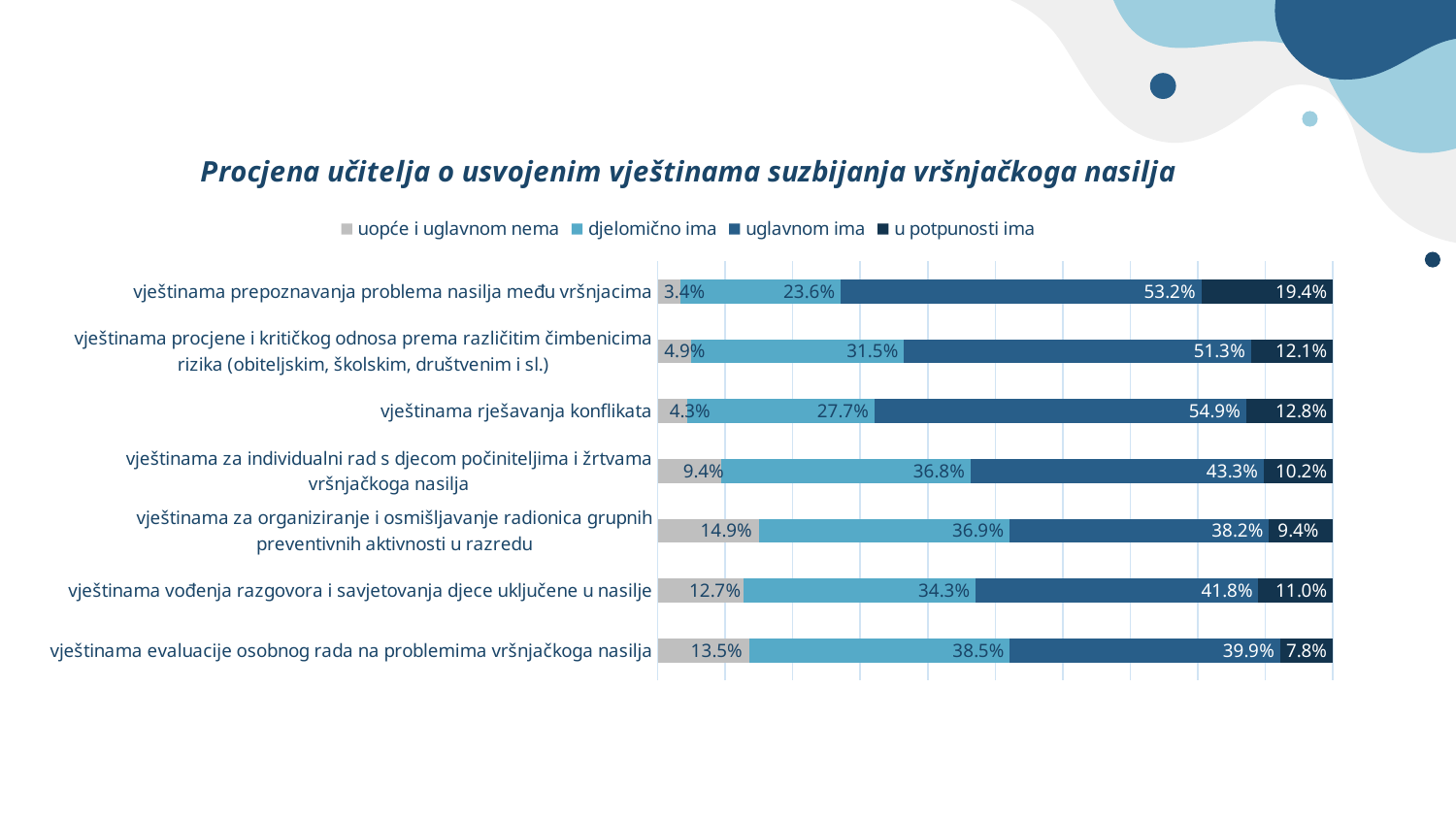
What percentage of teachers answered "uglavnom ima" for "vještinama rješavanja konflikata"? 54.9% Which category has the highest "uglavnom ima" value? vještinama rješavanja konflikata What is the value of the "u potpunosti ima" segment for "vještinama prepoznavanja problema nasilja među vršnjacima"? 19.4% How many series does the legend list? 4 How many categories (skills) are shown in the chart? 7 What is the title of the chart? Procjena učitelja o usvojenim vještinama suzbijanja vršnjačkoga nasilja What is the difference between the "uglavnom ima" and "u potpunosti ima" values for "vještinama prepoznavanja problema nasilja među vršnjacima"? 33.8 percentage points What is the "uopće i uglavnom nema" value for "vještinama za organiziranje i osmišljavanje radionica grupnih preventivnih aktivnosti u razredu"? 14.9% Which category has the lowest "u potpunosti ima" value? vještinama evaluacije osobnog rada na problemima vršnjačkoga nasilja Which is larger: the "djelomično ima" value for "vještinama evaluacije osobnog rada na problemima vršnjačkoga nasilja" or for "vještinama rješavanja konflikata"? vještinama evaluacije osobnog rada na problemima vršnjačkoga nasilja What is the total of the four segments for "vještinama prepoznavanja problema nasilja među vršnjacima"? 99.6% What type of chart is shown on the slide? Stacked bar chart